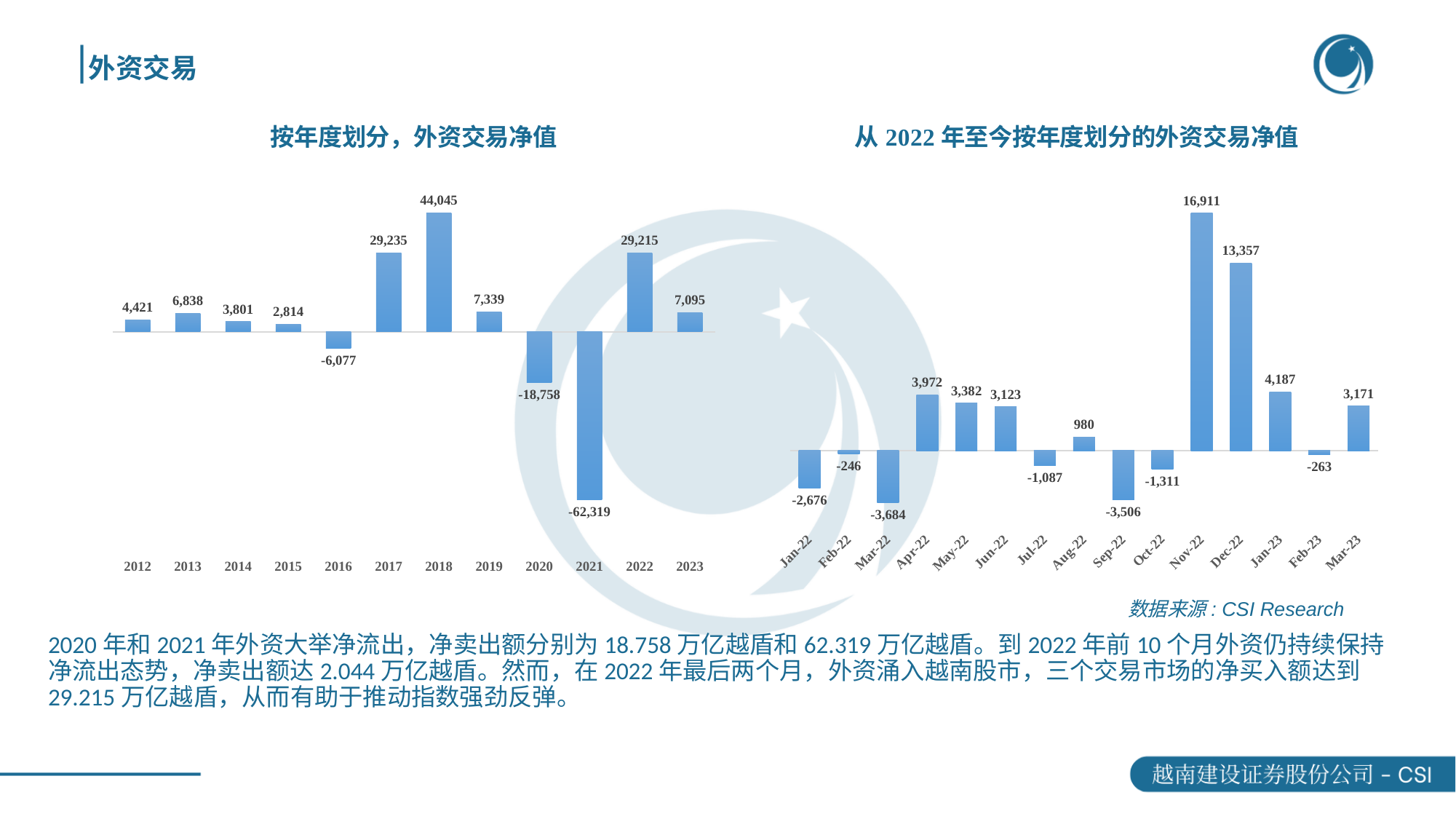
In the right chart (从 2022 年至今按年度划分的外资交易净值), which is larger, the value for Dec-22 or the value for Jan-23? Dec-22 In the left chart (按年度划分，外资交易净值), what is the difference between the values for 2017 and 2022? 20 In the left chart (按年度划分，外资交易净值), how many years are shown on the x axis? 12 In the left chart (按年度划分，外资交易净值), what is the value for 2018? 44,045 In the right chart (从 2022 年至今按年度划分的外资交易净值), how many months are shown on the x axis? 15 In the left chart (按年度划分，外资交易净值), what is the value for 2021? -62,319 In the right chart (从 2022 年至今按年度划分的外资交易净值), which month has the lowest value? Mar-22 In the right chart (从 2022 年至今按年度划分的外资交易净值), what is the value for Sep-22? -3,506 In the left chart (按年度划分，外资交易净值), which year has the lowest value? 2021 In the right chart (从 2022 年至今按年度划分的外资交易净值), what is the value for Nov-22? 16,911 In the left chart (按年度划分，外资交易净值), which year has the highest value? 2018 What type of chart is the right chart (从 2022 年至今按年度划分的外资交易净值)? Bar chart